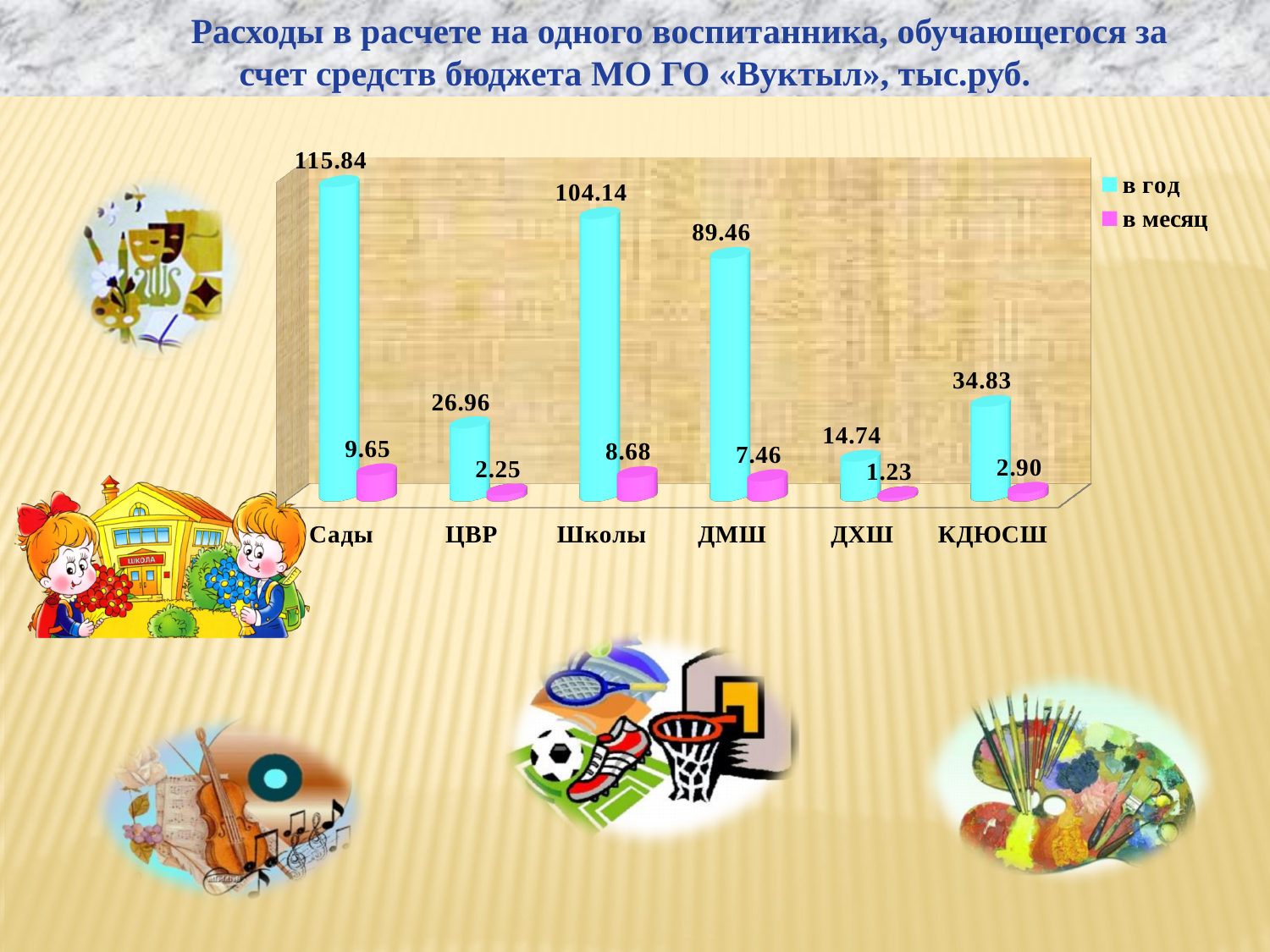
What is the value of 'в год' for КДЮСШ? 34.83 What kind of chart is shown on the slide? Bar chart How many series does the legend list? 2 Which is larger: the 'в год' value for ЦВР or for КДЮСШ? КДЮСШ Which series is shown in pink in the legend? в месяц What is the value of 'в год' for Сады? 115.84 What is the value of 'в месяц' for ДМШ? 7.46 Which category has the lowest 'в месяц' value? ДХШ How many categories are shown on the x axis? 6 Which category has the highest 'в год' value? Сады What is the difference between the 'в месяц' values for Школы and ЦВР? 6.43 What is the difference between the 'в год' values for Сады and Школы? 11.70